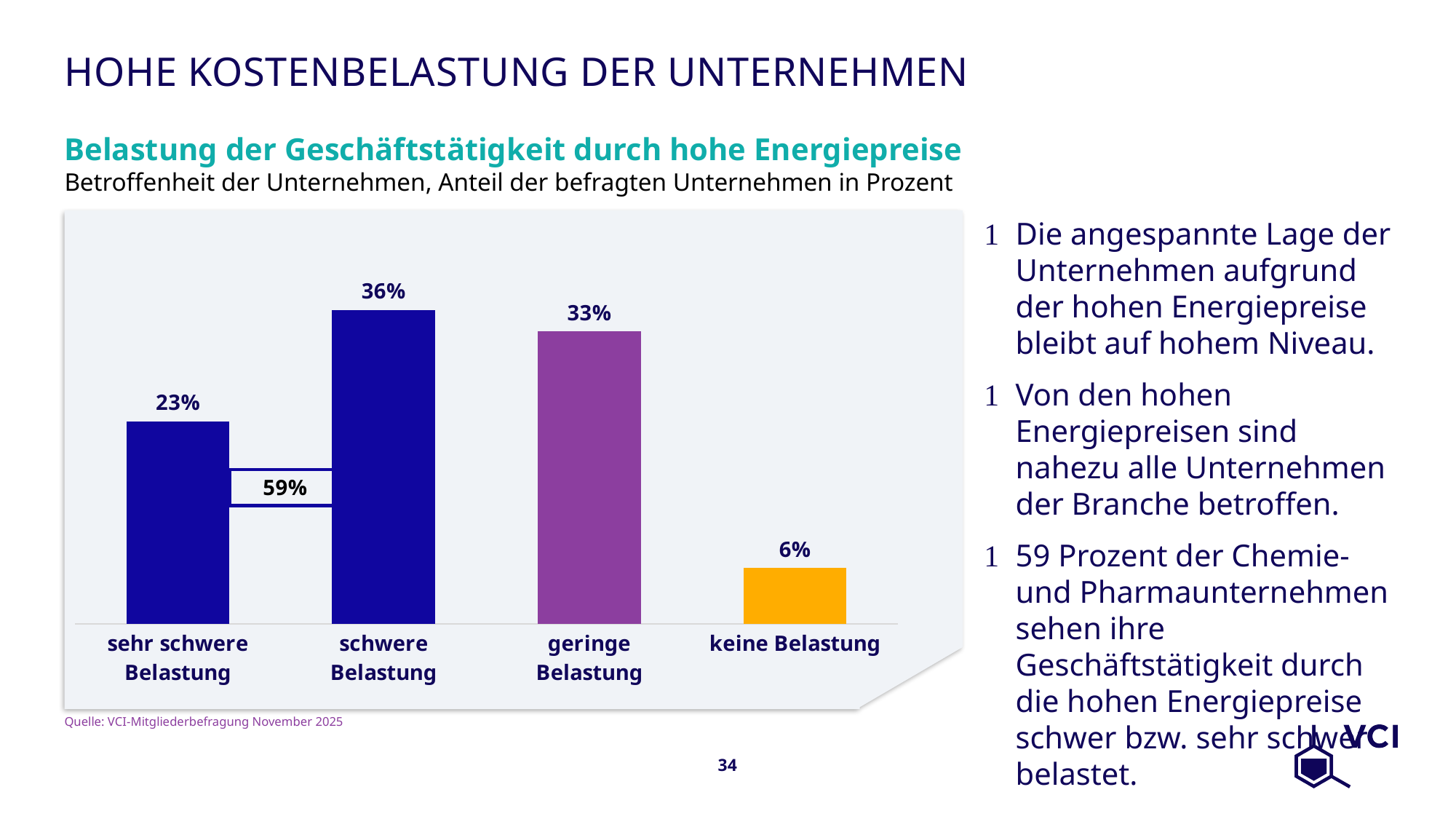
What is the title of the chart? Belastung der Geschäftstätigkeit durch hohe Energiepreise What is the value for "geringe Belastung"? 33% Which category has the lowest value? keine Belastung What is the value for "sehr schwere Belastung"? 23% What kind of chart is shown on the slide? bar chart What is the value for "schwere Belastung"? 36% Which category has the highest value? schwere Belastung What is the difference between "schwere Belastung" and "sehr schwere Belastung"? 13% Which is larger, "geringe Belastung" or "keine Belastung"? geringe Belastung What is the value for "keine Belastung"? 6% How many categories are shown in the chart? 4 What combined value is shown in the bracket linking "sehr schwere Belastung" and "schwere Belastung"? 59%